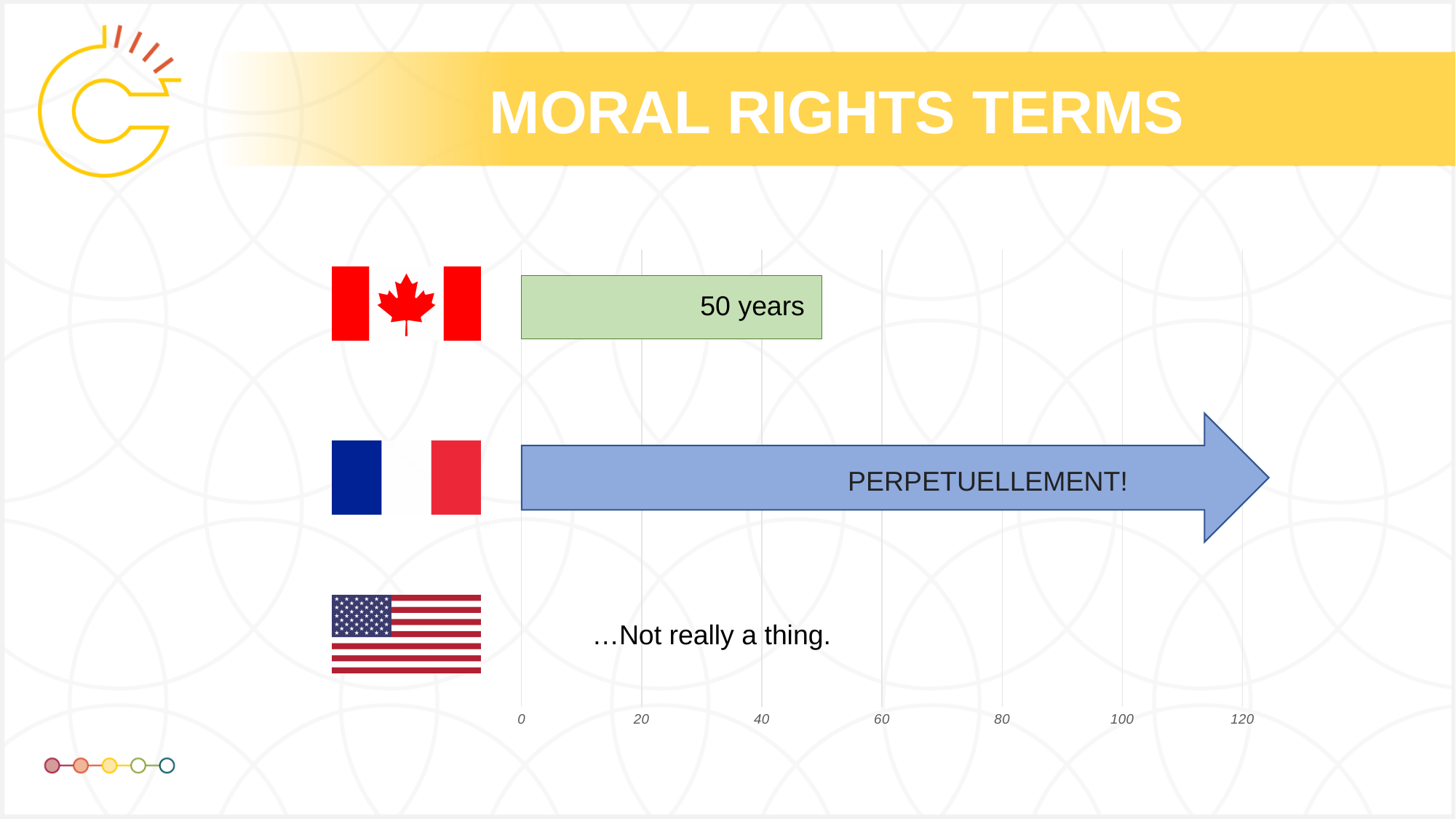
What text is printed on the arrow next to the French flag? PERPETUELLEMENT! What is the title of the slide containing the chart? MORAL RIGHTS TERMS What value is printed on the bar next to the Canadian flag? 50 years What text appears in the row next to the United States flag? …Not really a thing. Is the value for Canada greater or less than 40? greater Which country's row has the longest bar in the chart? France Does the arrow for France extend beyond the 100 tick on the axis, i.e. is its value greater or less than 100? greater What is the highest tick value shown on the horizontal axis? 120 How many countries (flags) are shown as categories in the chart? 3 Is the bar for Canada longer or shorter than the arrow for France? shorter What kind of chart is shown on the slide? bar chart Is the value for Canada greater or less than 60? less